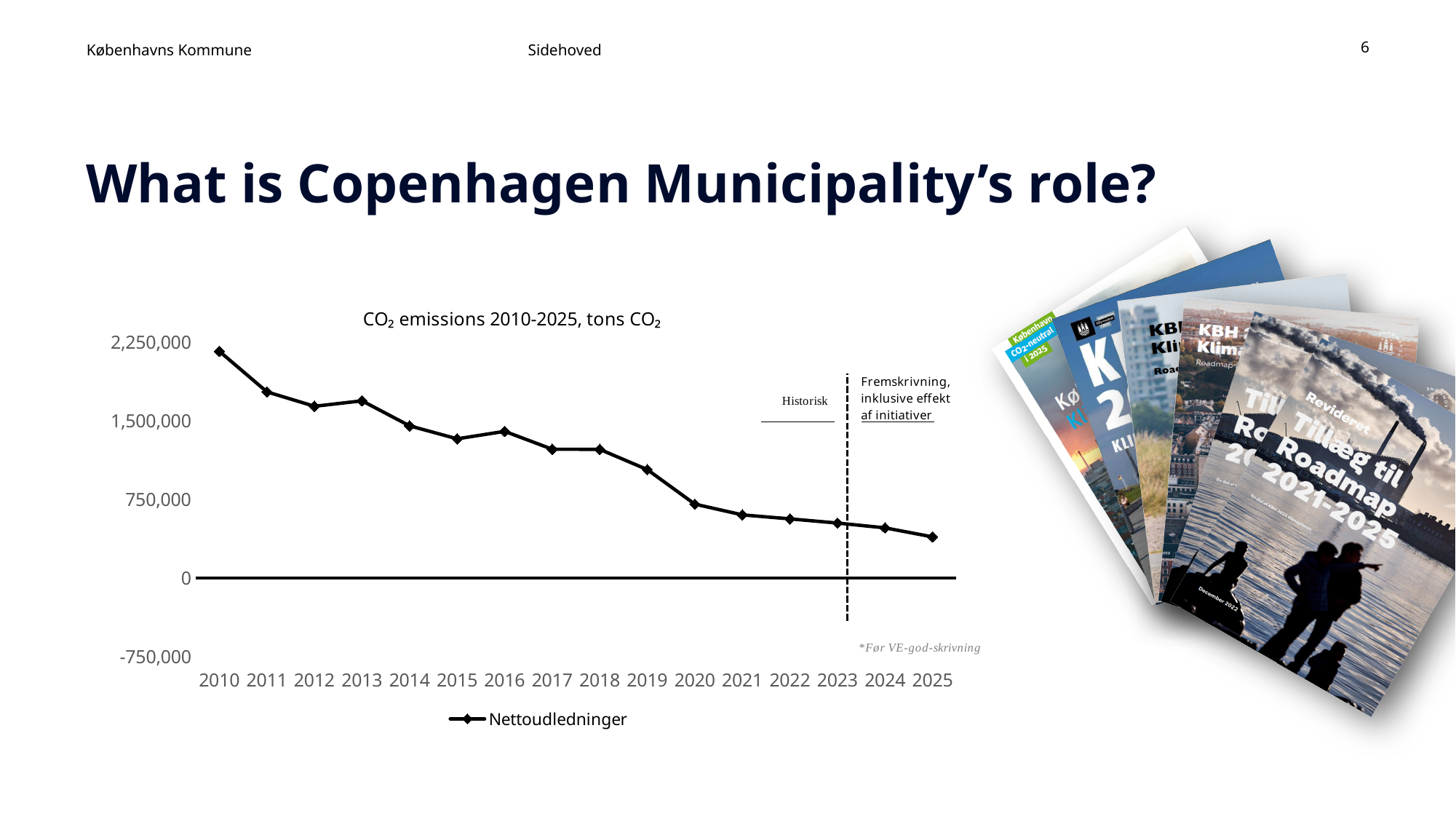
What is the name of the series shown in the legend? Nettoudledninger Do the values for Nettoudledninger generally rise or fall from 2010 to 2025? fall How many series does the chart legend list? 1 How many years are plotted along the x axis? 16 What is the title of the chart? CO₂ emissions 2010-2025, tons CO₂ What kind of chart is shown on the slide? line chart Is the value for 2010 greater or less than 1,500,000? greater Which year has the larger value, 2018 or 2020? 2018 Which year has the lowest value for Nettoudledninger? 2025 Is the value for 2019 greater or less than 750,000? greater Which year has the highest value for Nettoudledninger? 2010